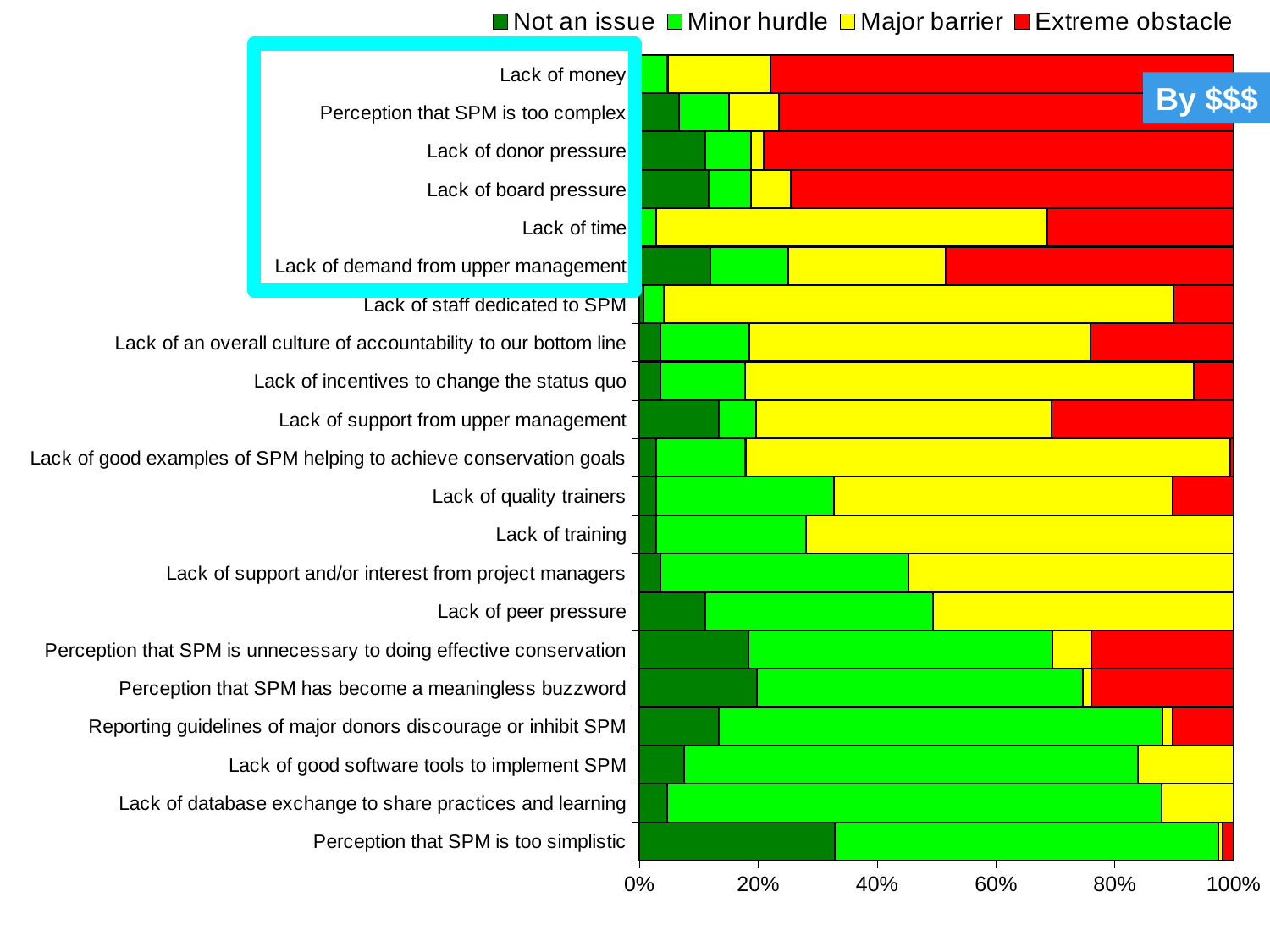
What text appears in the blue label box at the top right of the chart? By $$$ Is the 'Extreme obstacle' share for 'Lack of money' greater or less than 60%? greater How many categories (obstacles) are plotted on the chart? 21 Which category has the largest 'Minor hurdle' share? Lack of database exchange to share practices and learning How many series does the legend list? 4 What kind of chart is shown on the slide? Stacked bar chart Is the 'Major barrier' share for 'Lack of support and/or interest from project managers' greater or less than 40%? greater Which series is shown in red in the legend? Extreme obstacle Which has the larger 'Extreme obstacle' share: 'Lack of money' or 'Lack of time'? Lack of money Which category has the largest 'Not an issue' share? Perception that SPM is too simplistic Is the 'Major barrier' share for 'Lack of time' greater or less than 60%? greater